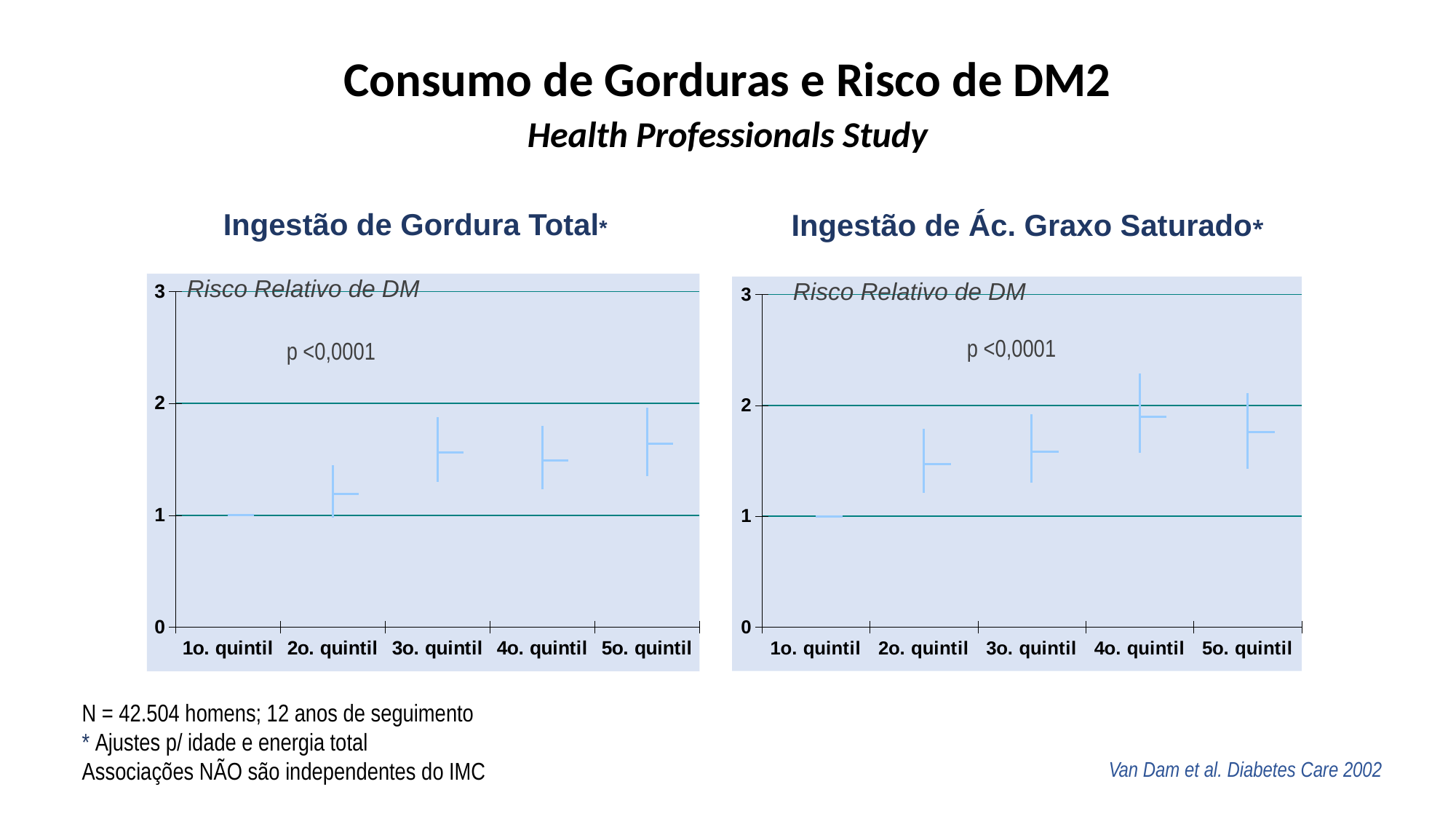
What is the y-axis label shown in the chart titled "Ingestão de Gordura Total"? Risco Relativo de DM In the chart titled "Ingestão de Ác. Graxo Saturado", what is the relative risk for 1o. quintil? 1 In the chart titled "Ingestão de Ác. Graxo Saturado", is the value for 2o. quintil greater or less than 1? greater In the chart titled "Ingestão de Gordura Total", which has the larger relative risk, 2o. quintil or 3o. quintil? 3o. quintil In the chart titled "Ingestão de Gordura Total", is the value for 3o. quintil greater or less than 1? greater In the chart titled "Ingestão de Ác. Graxo Saturado", does the relative risk generally rise or fall from 1o. quintil to 4o. quintil? rise What p value is printed inside the chart titled "Ingestão de Ác. Graxo Saturado"? p <0,0001 In the chart titled "Ingestão de Ác. Graxo Saturado", which quintile has the highest relative risk? 4o. quintil In the chart titled "Ingestão de Gordura Total", which quintile has the lowest relative risk? 1o. quintil In the chart titled "Ingestão de Gordura Total", is the value for 5o. quintil greater or less than 2? less In the chart titled "Ingestão de Gordura Total", how many quintile categories are shown on the x axis? 5 In the chart titled "Ingestão de Ác. Graxo Saturado", which has the larger relative risk, 2o. quintil or 4o. quintil? 4o. quintil